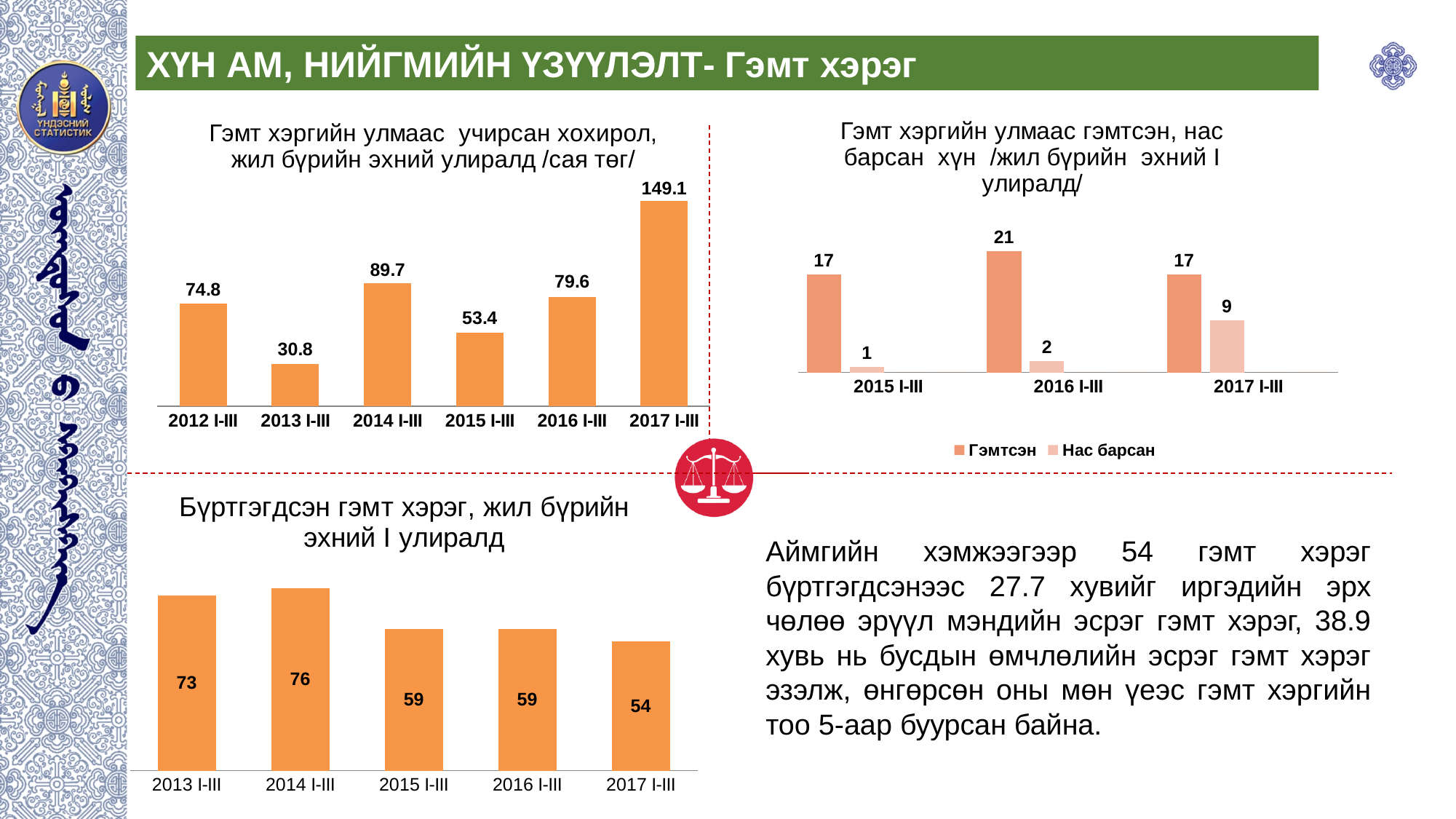
In the top-left chart (Гэмт хэргийн улмаас учирсан хохирол), how many periods are shown on the x axis? 6 In the bottom-left chart (Бүртгэгдсэн гэмт хэрэг), which period has the highest value? 2014 I-III In the top-right chart (Гэмт хэргийн улмаас гэмтсэн, нас барсан хүн), what is the Нас барсан value for 2017 I-III? 9 What kind of chart is the bottom-left chart (Бүртгэгдсэн гэмт хэрэг)? bar chart In the bottom-left chart (Бүртгэгдсэн гэмт хэрэг), what is the value for 2014 I-III? 76 In the top-left chart (Гэмт хэргийн улмаас учирсан хохирол), what is the value for 2017 I-III? 149.1 In the top-right chart (Гэмт хэргийн улмаас гэмтсэн, нас барсан хүн), what is the Гэмтсэн value for 2016 I-III? 21 In the top-right chart (Гэмт хэргийн улмаас гэмтсэн, нас барсан хүн), does the Нас барсан value rise or fall from 2015 I-III to 2017 I-III? rise In the top-right chart (Гэмт хэргийн улмаас гэмтсэн, нас барсан хүн), how many series does the legend list? 2 In the top-left chart (Гэмт хэргийн улмаас учирсан хохирол), what is the difference between the 2017 I-III and 2016 I-III values? 69.5 In the bottom-left chart (Бүртгэгдсэн гэмт хэрэг), what is the difference between the 2016 I-III and 2017 I-III values? 5 In the top-left chart (Гэмт хэргийн улмаас учирсан хохирол), which period has the lowest value? 2013 I-III